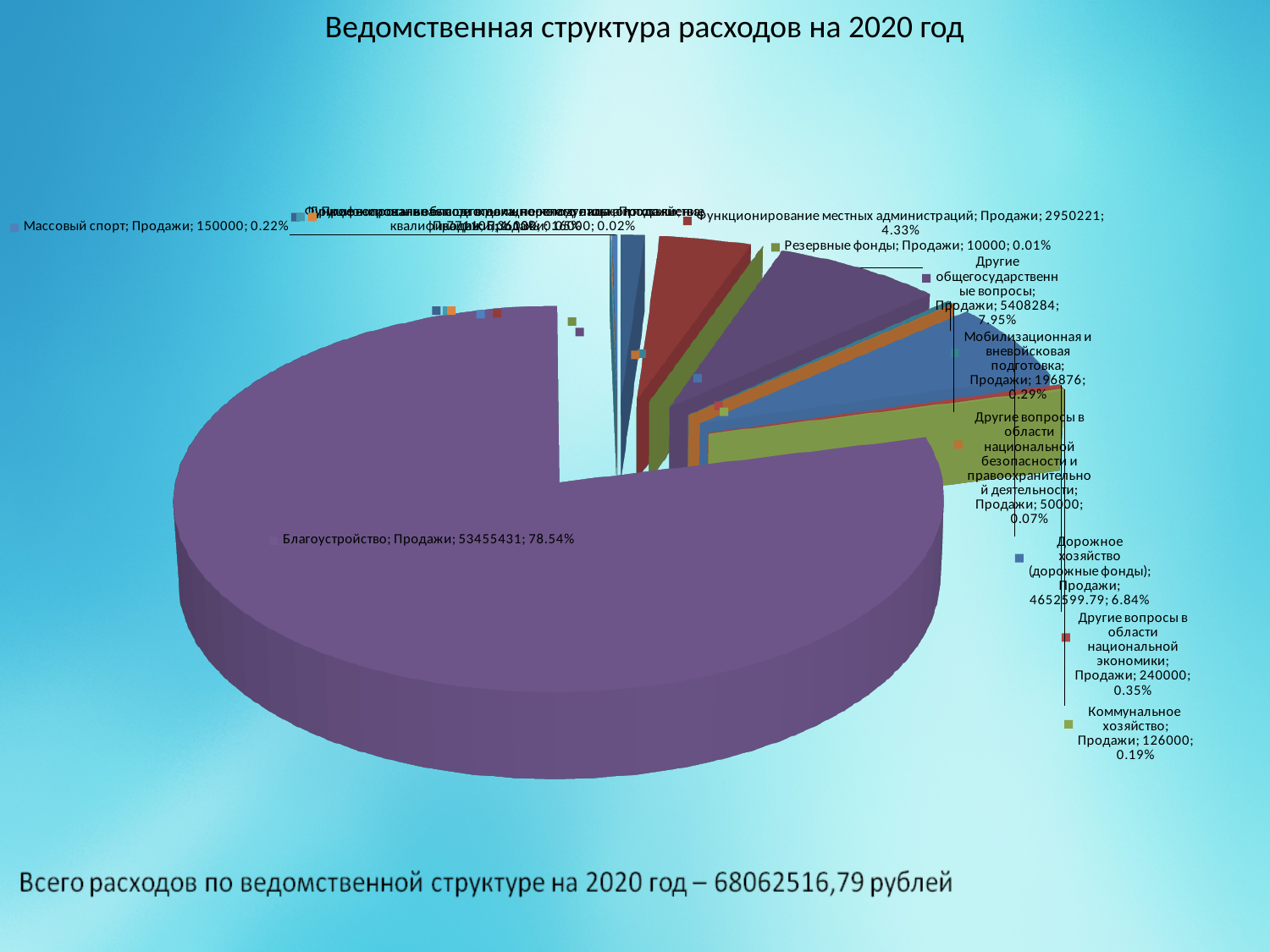
What is the value for Резервные фонды? 10000 Which is larger, the value for Массовый спорт or the value for Коммунальное хозяйство? Массовый спорт What is the value for Благоустройство? 53455431 What is the value for Функционирование местных администраций? 2950221 What share of the pie does Мобилизационная и вневойсковая подготовка represent? 0.29% What share of the pie does Другие общегосударственные вопросы represent? 7.95% What kind of chart is shown on the slide? pie chart Which category has the largest share of the pie? Благоустройство What is the title of the chart? Ведомственная структура расходов на 2020 год What is the value for Дорожное хозяйство (дорожные фонды)? 4652599.79 What share of the pie does Благоустройство represent? 78.54% What is the difference between the values for Другие вопросы в области национальной экономики and Массовый спорт? 90000